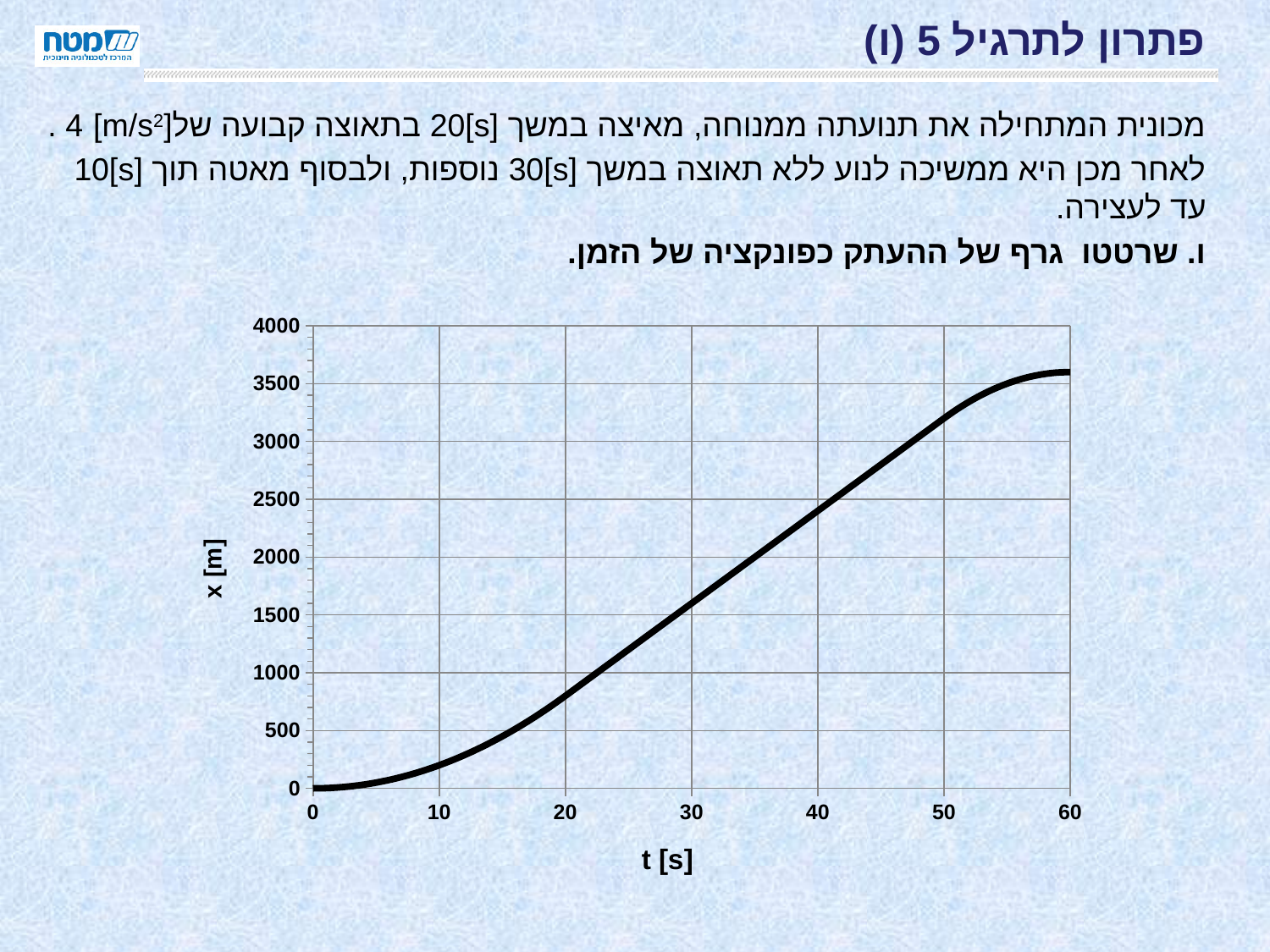
What is the label of the vertical axis of the chart? x [m] Is the value of x at t = 60 greater or less than 4000? less Is the value of x at t = 30 greater or less than 1000? greater What is the label of the horizontal axis of the chart? t [s] Do the values on the chart rise or fall as t increases from 0 to 60? rise Is the value of x at t = 10 greater or less than 500? less What is the value of x at t = 0 on the chart? 0 At which of the two times, t = 20 or t = 50, is the value of x larger? t = 50 What kind of chart is shown on the slide? line chart